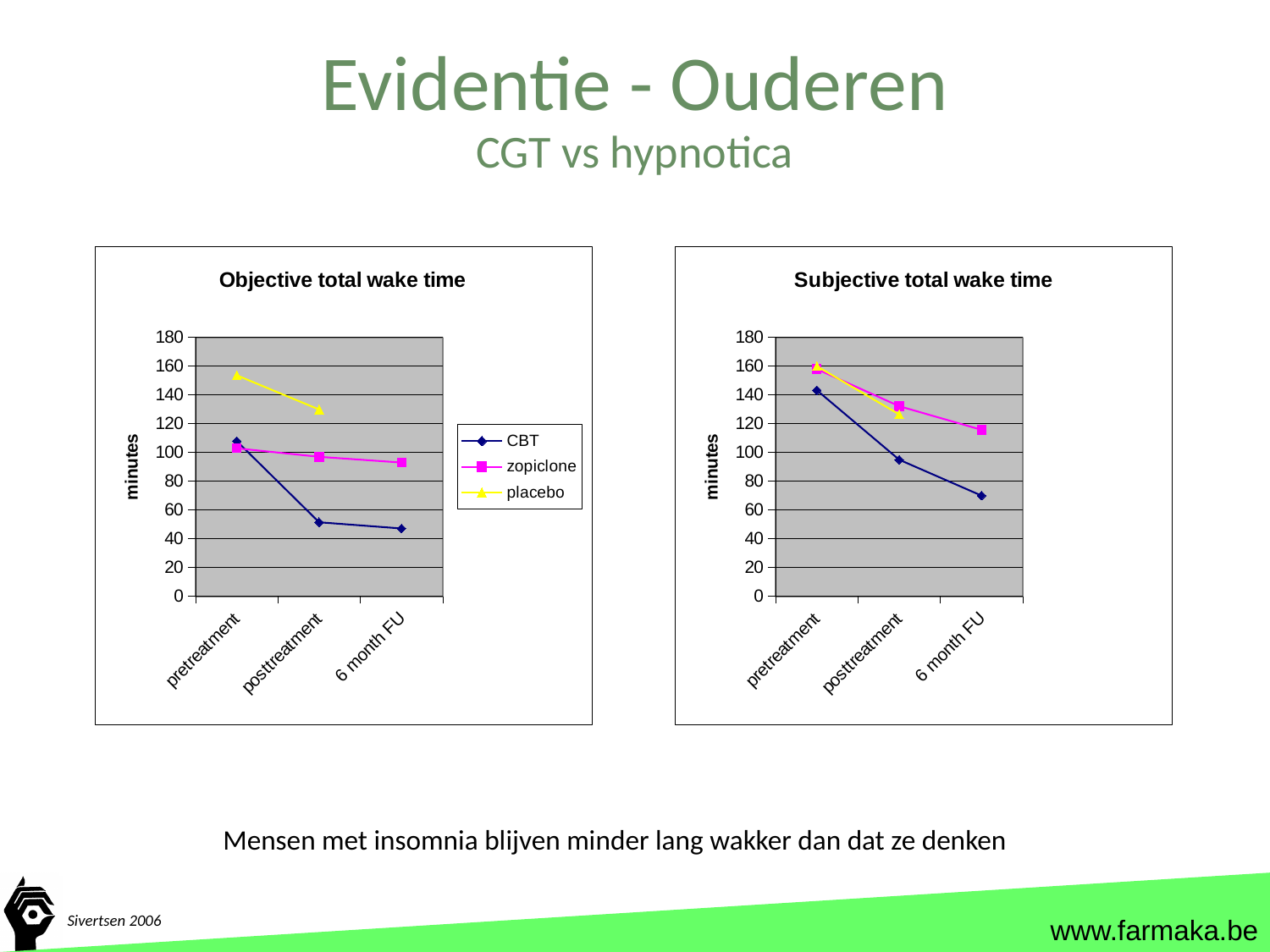
What is the y-axis label on the 'Subjective total wake time' chart? minutes In the 'Subjective total wake time' chart, is the CBT value at 6 month FU greater or less than 80? less How many time points are shown on the x axis of the 'Subjective total wake time' chart? 3 In the 'Objective total wake time' chart, is the CBT value at posttreatment greater or less than 60? less What kind of chart is the 'Objective total wake time' chart? line chart In the 'Subjective total wake time' chart, which series has the lowest value at pretreatment? CBT How many series does the legend of the 'Objective total wake time' chart list? 3 In the 'Objective total wake time' chart, which series has the highest value at pretreatment? placebo In the 'Subjective total wake time' chart, does the zopiclone line rise or fall across the x axis? fall In the 'Objective total wake time' chart, is the placebo value at pretreatment greater or less than 140? greater In the 'Objective total wake time' chart, does the CBT line rise or fall from pretreatment to 6 month FU? fall In the 'Objective total wake time' chart, which is larger at 6 month FU: zopiclone or CBT? zopiclone